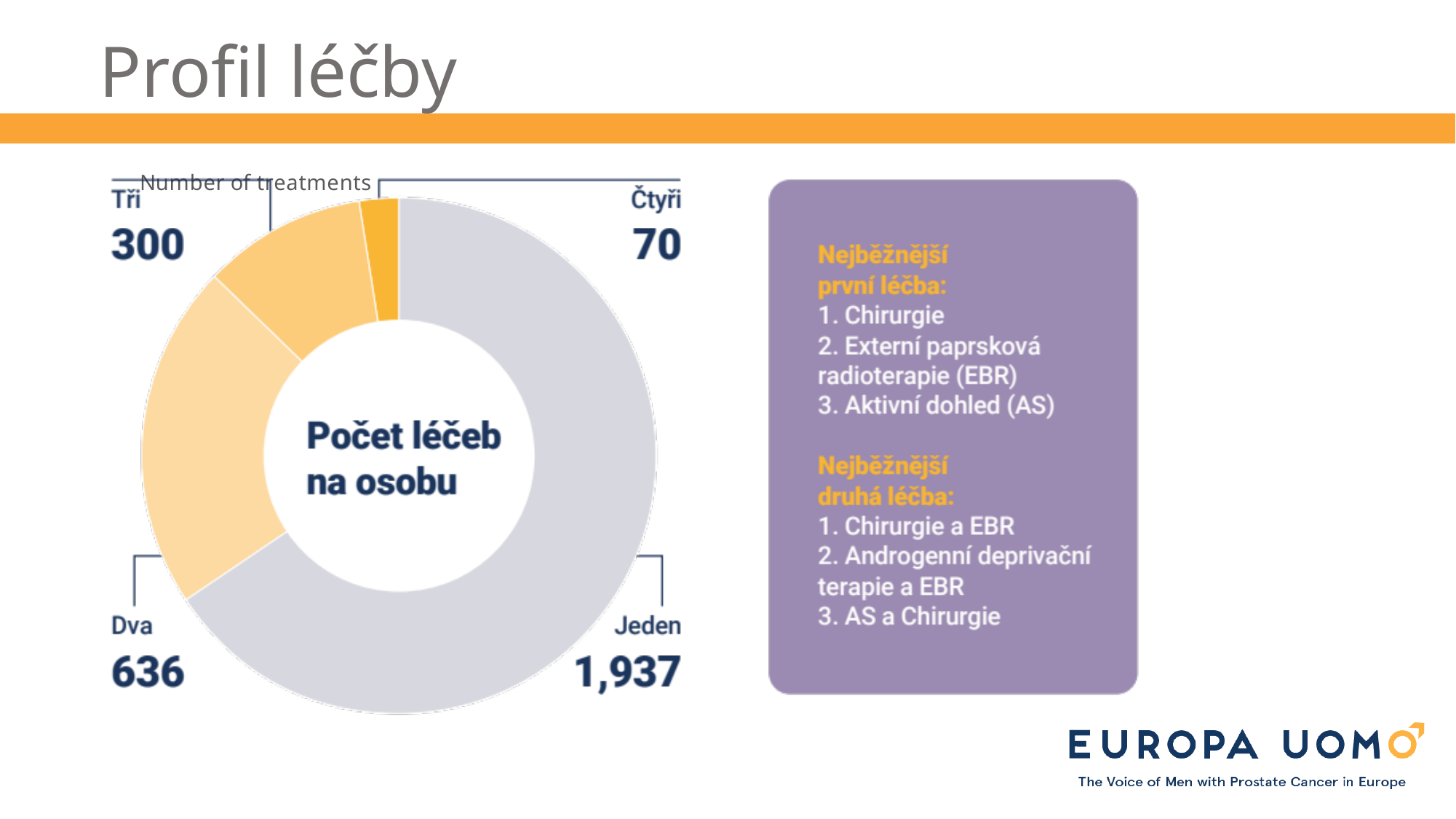
Which category has the largest value in the donut chart? Jeden Which category has the smallest value in the donut chart? Čtyři What is the value for the "Dva" segment of the donut chart? 636 What is the value for the "Čtyři" segment of the donut chart? 70 What is the difference between the values for "Dva" and "Tři" in the donut chart? 336 What is the value for the "Jeden" segment of the donut chart? 1,937 What is the total of all four segment values in the donut chart? 2,943 What kind of chart is shown on the slide? Donut (pie) chart What is the value for the "Tři" segment of the donut chart? 300 Which is larger in the donut chart, the value for "Tři" or the value for "Čtyři"? Tři What text is written in the centre of the donut chart? Počet léčeb na osobu How many segments does the donut chart have? 4